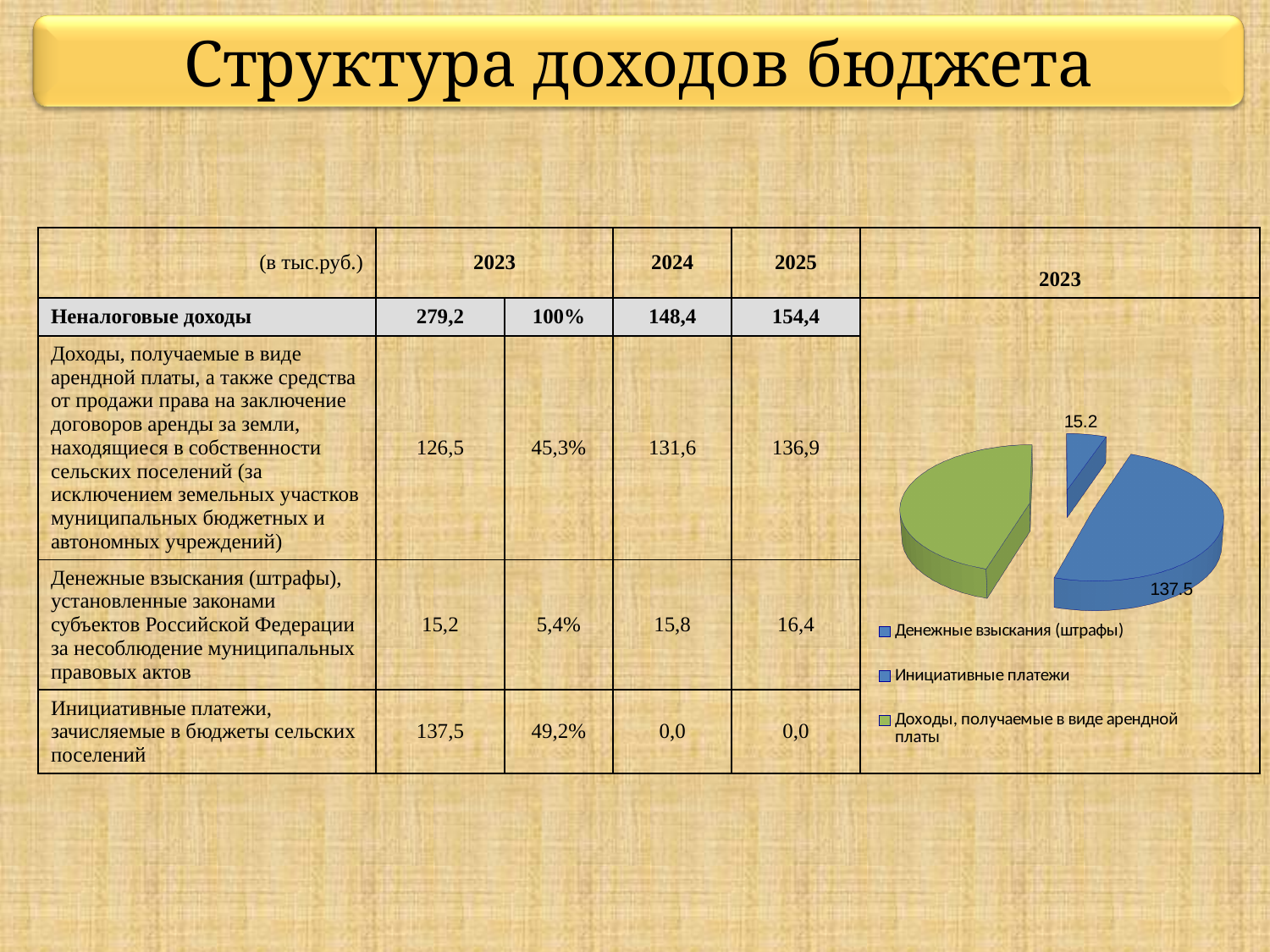
How many slices does the pie chart have? 3 What is the title of the pie chart? 2023 In the pie chart, which is larger: Доходы, получаемые в виде арендной платы or Денежные взыскания (штрафы)? Доходы, получаемые в виде арендной платы What value is shown on the pie chart for Инициативные платежи? 137.5 What is the difference between the values for Инициативные платежи and Денежные взыскания (штрафы) in the pie chart? 122.3 What colour is the slice for Доходы, получаемые в виде арендной платы in the pie chart? green How many entries does the pie chart's legend list? 3 Which slice of the pie chart is the smallest? Денежные взыскания (штрафы) What type of chart is shown on the slide? pie chart What value is shown on the pie chart for Денежные взыскания (штрафы)? 15.2 In the pie chart, which is larger: Инициативные платежи or Денежные взыскания (штрафы)? Инициативные платежи